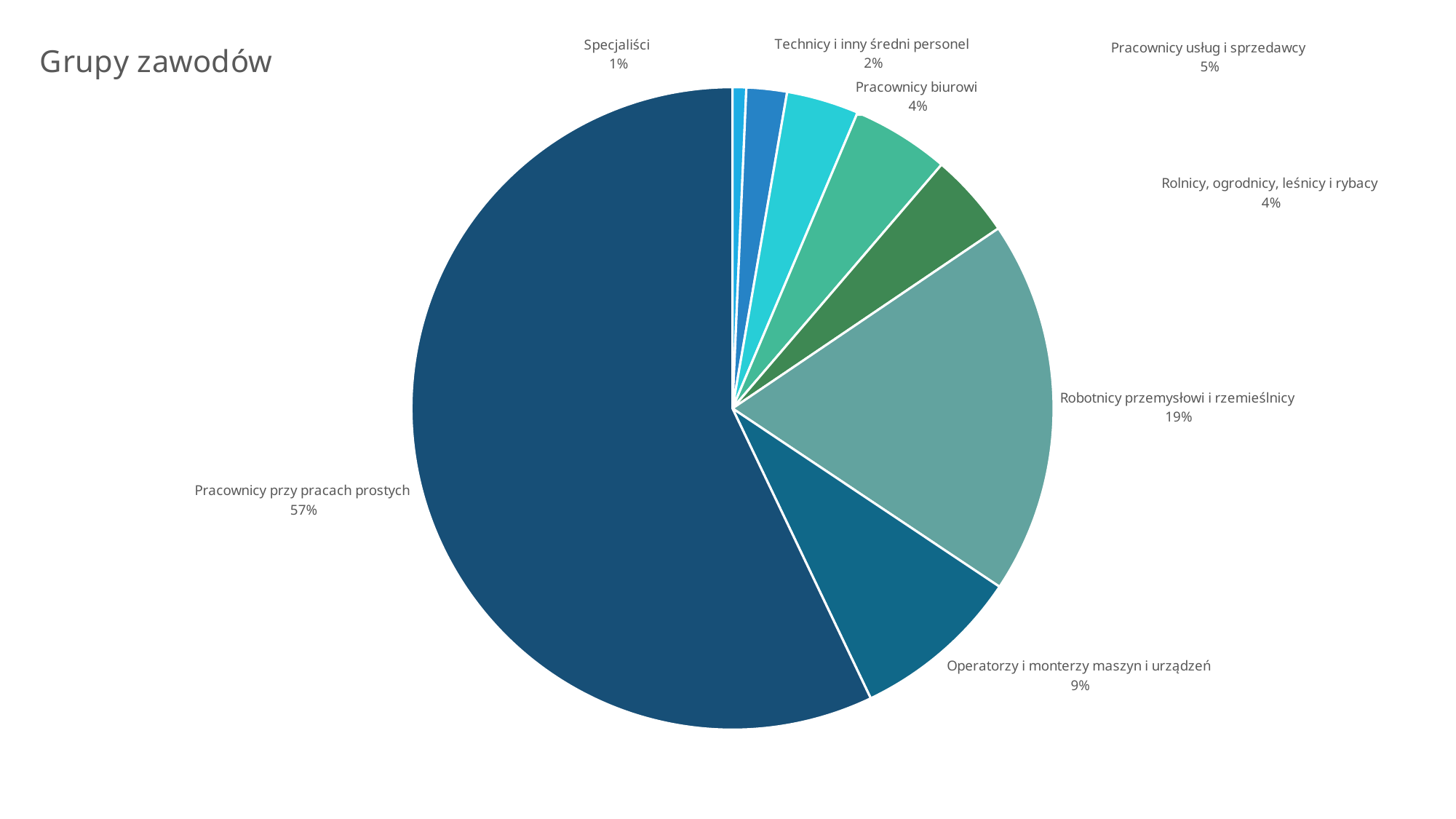
What is the value for Operatorzy i monterzy maszyn i urządzeń? 9% What is the value for Pracownicy usług i sprzedawcy? 5% What is the title of the chart? Grupy zawodów What kind of chart is shown on the slide? pie chart Which is larger, Operatorzy i monterzy maszyn i urządzeń or Pracownicy usług i sprzedawcy? Operatorzy i monterzy maszyn i urządzeń Which category has the smallest slice? Specjaliści What is the difference between Pracownicy przy pracach prostych and Robotnicy przemysłowi i rzemieślnicy? 38% What is the value for Robotnicy przemysłowi i rzemieślnicy? 19% What is the value for Technicy i inny średni personel? 2% What share of the pie does Pracownicy przy pracach prostych have? 57% Which category has the largest slice? Pracownicy przy pracach prostych How many categories are shown in the pie chart? 8